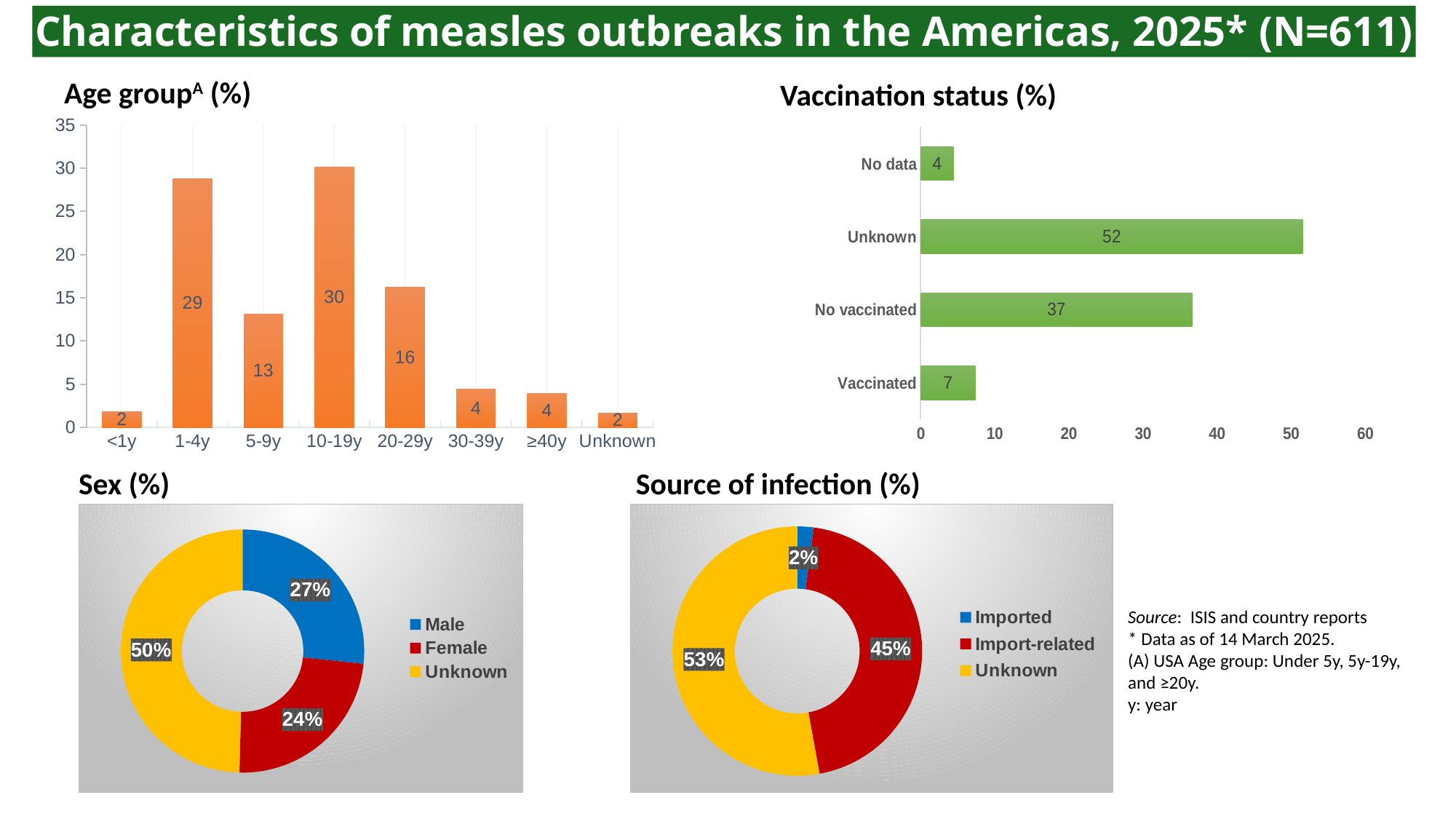
In the Vaccination status chart, what is the value for Unknown? 52 What kind of chart is the Vaccination status chart? Bar chart In the Age group chart, how many age group categories are shown on the x axis? 8 In the Age group chart, what is the value for the 10-19y age group? 30 In the Age group chart, what is the difference between the values for 1-4y and 5-9y? 16 In the Vaccination status chart, which category has the lowest value? No data In the Vaccination status chart, which is larger, No vaccinated or Vaccinated? No vaccinated In the Source of infection chart, what share is Import-related? 45% In the Source of infection chart, which category has the smallest share? Imported In the Sex chart, what share is Female? 24% In the Age group chart, which age group has the highest value? 10-19y In the Sex chart, how many series does the legend list? 3